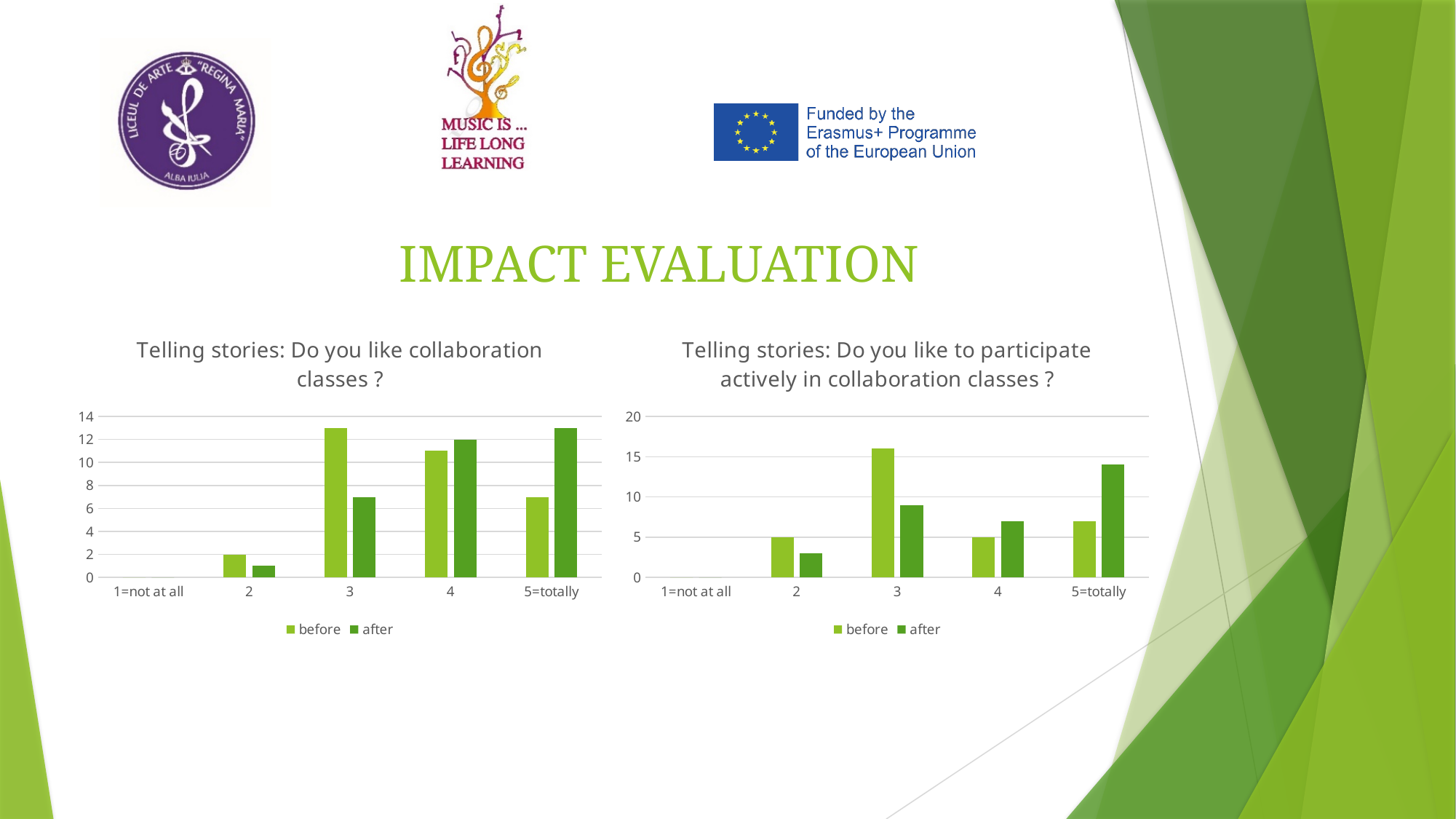
In the right chart 'Do you like to participate actively in collaboration classes ?', is the 'after' value for '5=totally' greater or less than 10? greater How many series does the legend of the right chart list? 2 In the left chart 'Do you like collaboration classes ?', for category 3, which series is larger, 'before' or 'after'? before What type of chart is the left chart 'Do you like collaboration classes ?'? bar chart In the left chart 'Do you like collaboration classes ?', is the 'before' value for category 3 greater or less than 12? greater In the right chart 'Do you like to participate actively in collaboration classes ?', which category has the highest 'after' value? 5=totally In the right chart 'Do you like to participate actively in collaboration classes ?', what is the 'before' value for category 4? 5 In the left chart 'Do you like collaboration classes ?', which category has the highest 'before' value? 3 In the left chart 'Do you like collaboration classes ?', what is the 'after' value for category 4? 12 In the right chart 'Do you like to participate actively in collaboration classes ?', what is the 'before' value for category 2? 5 In the right chart 'Do you like to participate actively in collaboration classes ?', is the 'before' value for category 3 greater or less than 15? greater In the left chart 'Do you like collaboration classes ?', what is the 'before' value for category 2? 2